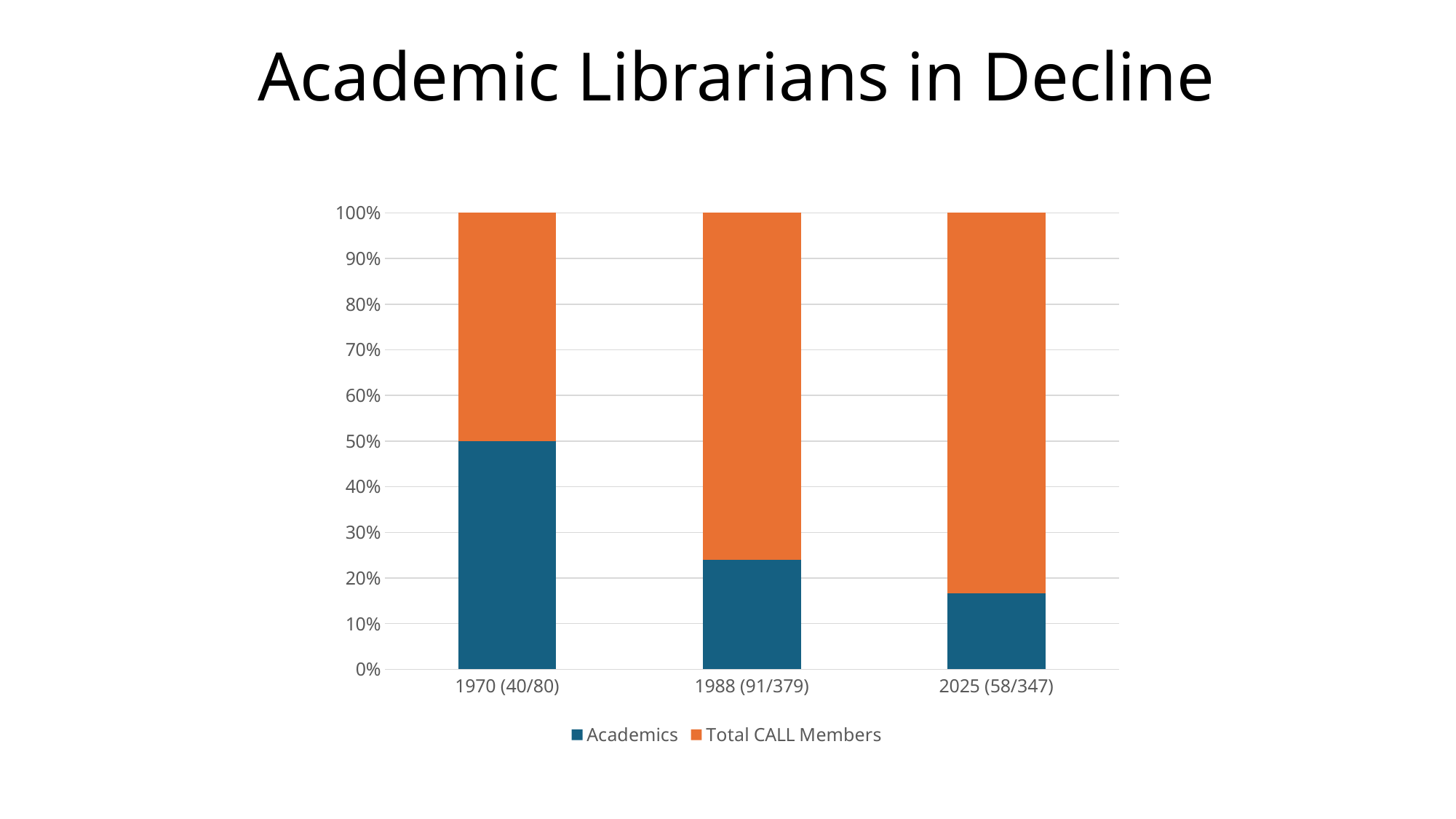
Does the Academics share rise or fall from 1970 to 2025 along the x axis? fall Which category has the highest Academics share? 1970 (40/80) What kind of chart is shown on the slide? bar chart Which series is shown in orange in the legend? Total CALL Members What is the title of the chart on the slide? Academic Librarians in Decline How many series does the legend list? 2 What is the Academics share for the 1970 (40/80) bar? 50% Is the Academics share for 1988 (91/379) greater or less than 20%? greater Is the Academics share for 1988 (91/379) greater or less than 30%? less How many categories are shown on the x axis? 3 Which category has the lowest Academics share? 2025 (58/347) Is the Academics share for 2025 (58/347) greater or less than 20%? less